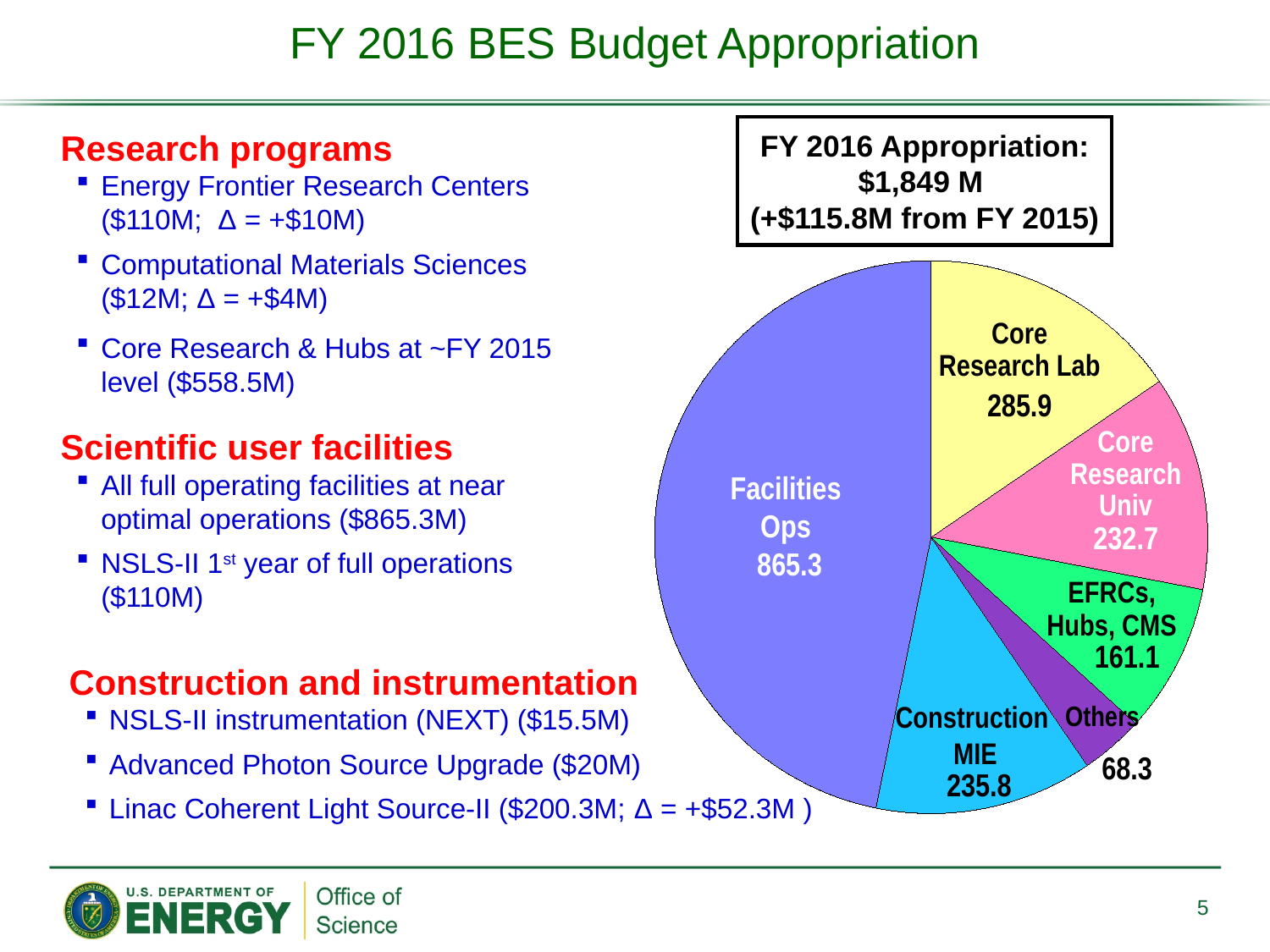
Which slice of the pie chart is the smallest? Others What is the value of the Core Research Lab slice? 285.9 What kind of chart is shown on the slide? pie chart How many slices does the pie chart have? 6 What is the difference between the Construction MIE value and the Others value? 167.5 What is the difference between the Core Research Lab value and the Core Research Univ value? 53.2 What total appropriation amount is stated in the box above the pie chart? $1,849 M Which is larger, the Core Research Lab slice or the EFRCs, Hubs, CMS slice? Core Research Lab Which slice of the pie chart is the largest? Facilities Ops What is the value of the Facilities Ops slice in the pie chart? 865.3 What is the value of the Construction MIE slice? 235.8 What is the value of the EFRCs, Hubs, CMS slice? 161.1